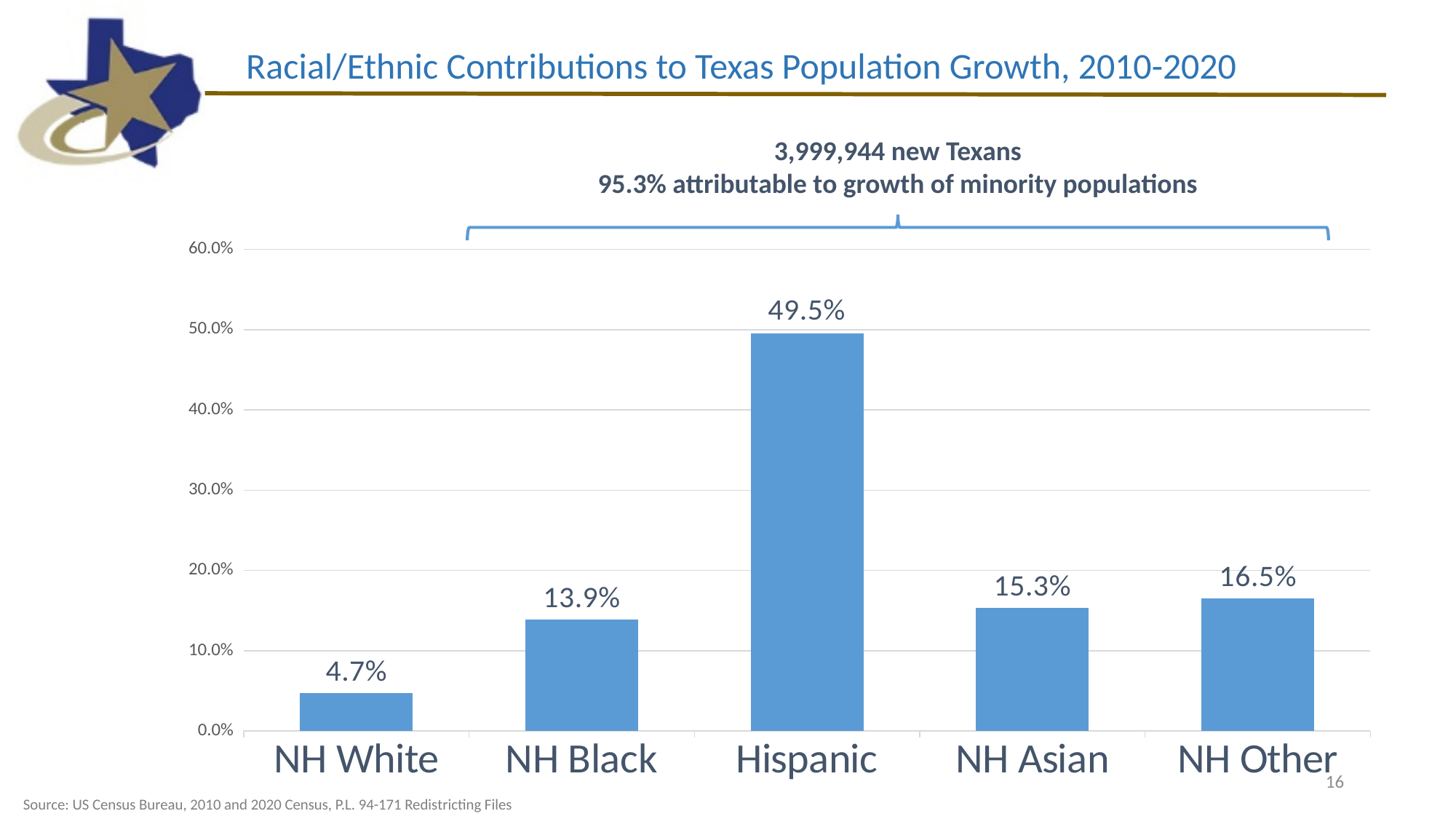
What is the value for Hispanic? 49.5% What is the value for NH Asian? 15.3% Which is larger, the value for NH Black or the value for NH Other? NH Other How many categories are shown on the x axis? 5 What is the title of the chart? Racial/Ethnic Contributions to Texas Population Growth, 2010-2020 Which category has the highest value? Hispanic What is the difference between the values for NH Other and NH White? 11.8% Is the value for Hispanic greater or less than 40.0%? greater What is the difference between the values for Hispanic and NH Black? 35.6% Which category has the lowest value? NH White What kind of chart is shown on the slide? bar chart What is the value for NH White? 4.7%